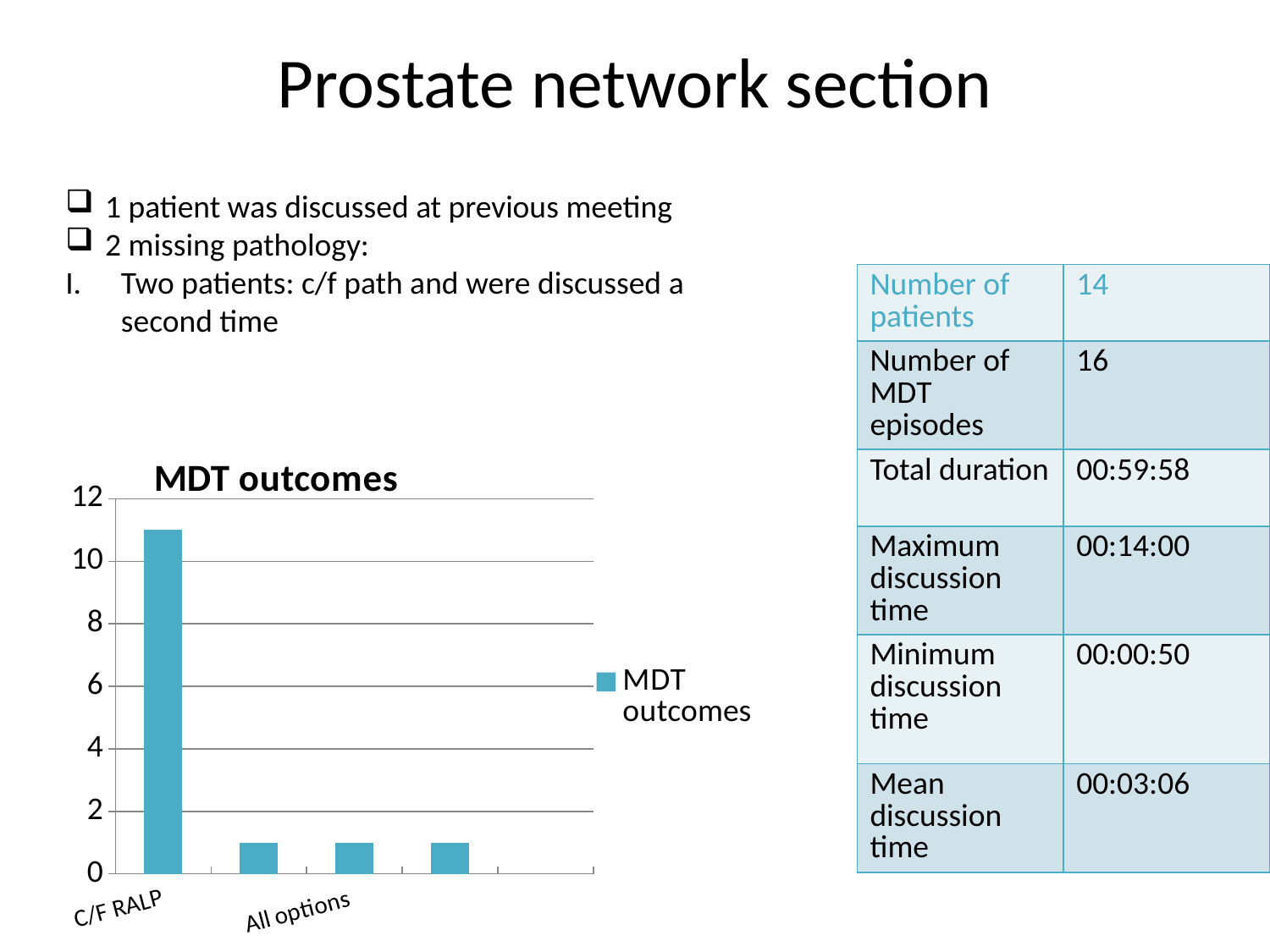
What is the name of the series shown in the legend? MDT outcomes Is the value for C/F RALP greater or less than 10? greater How many bars are plotted in the MDT outcomes chart? 4 What kind of chart is shown on the slide? bar chart Is the value for All options greater or less than 2? less What is the title of the chart? MDT outcomes Which category has the highest value in the MDT outcomes chart? C/F RALP What is the highest value shown on the vertical axis of the chart? 12 Which has the larger value, C/F RALP or All options? C/F RALP How many series does the chart legend list? 1 Is the value for C/F RALP greater or less than 12? less